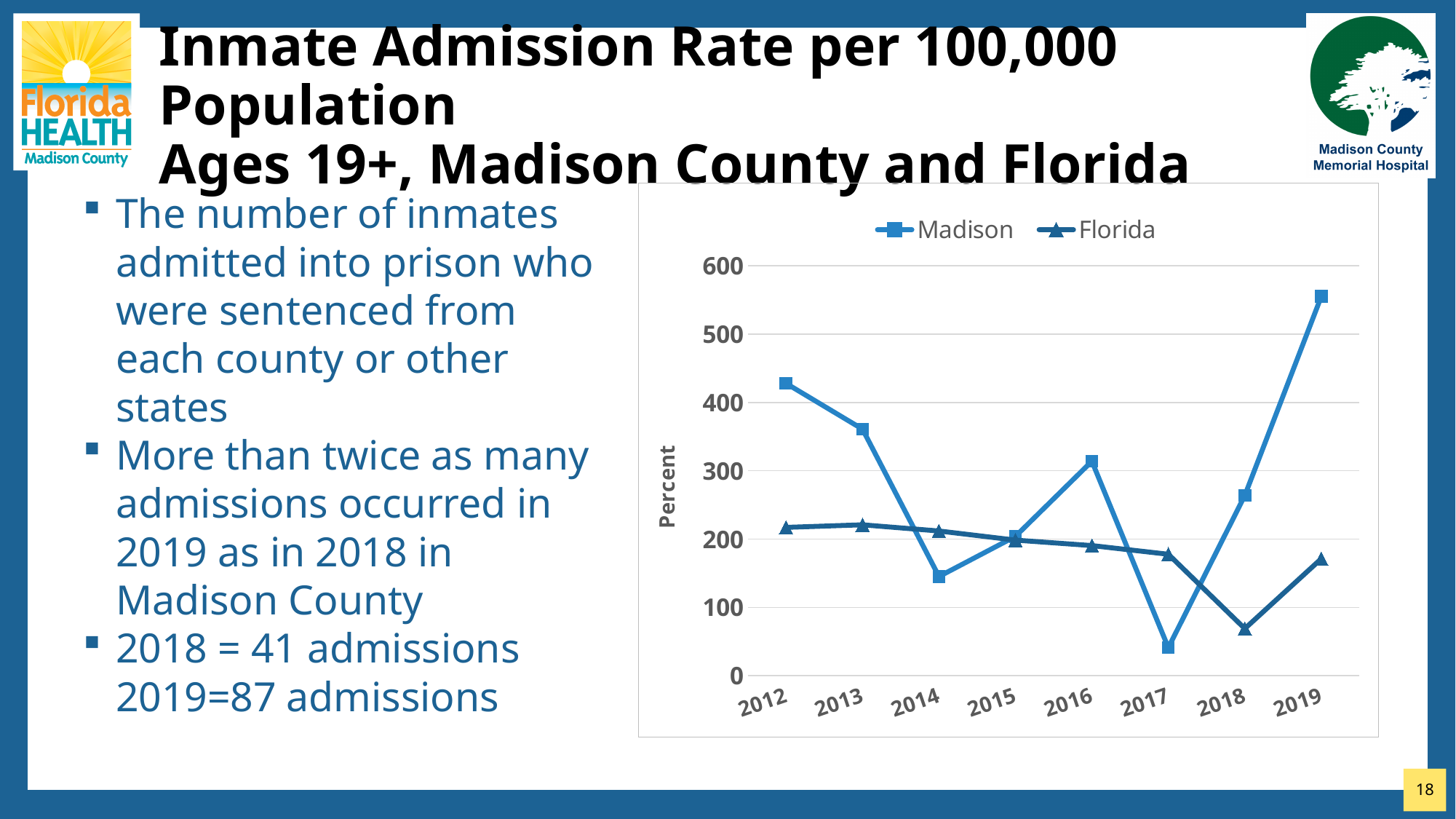
How many years are plotted along the x axis of the chart? 8 In which year is the Madison series at its lowest? 2017 Is the Madison value for 2019 greater or less than 500? greater Is the Florida value for 2018 greater or less than 100? less In 2017, which series has the higher value, Madison or Florida? Florida Is the Madison value for 2017 greater or less than 100? less In which year is the Florida series at its lowest? 2018 How many series does the chart legend list? 2 Does the Florida series rise or fall from 2012 to 2017? fall What kind of chart is shown on the slide? line chart In 2012, which series has the higher value, Madison or Florida? Madison In which year is the Madison series at its highest? 2019